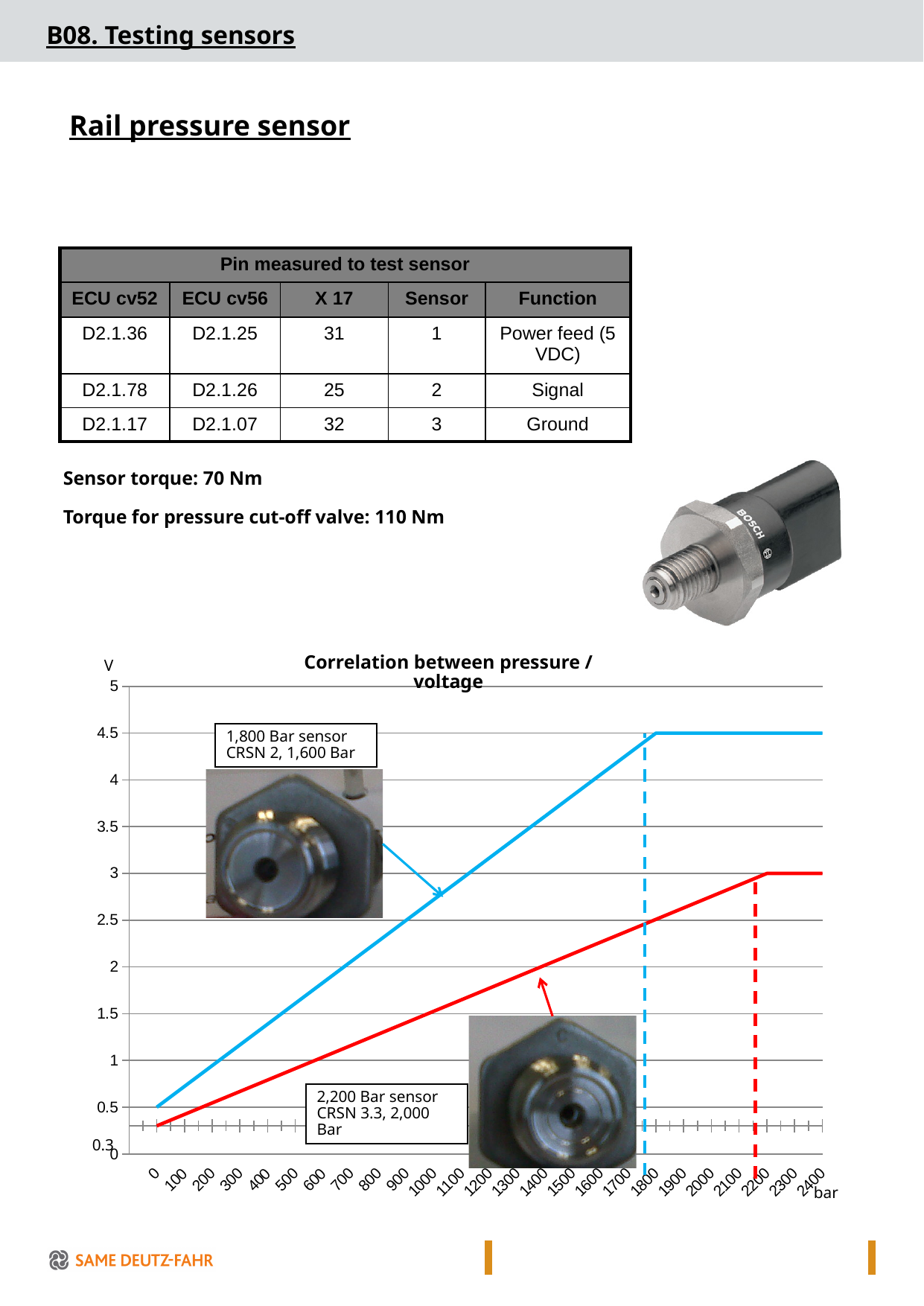
What maximum voltage does the 1,800 Bar sensor (blue line) level off at? 4.5 Is the voltage of the 1,800 Bar sensor (blue line) at 1000 bar greater or less than 2? greater How many sensor curves are plotted on the pressure/voltage chart? 2 Which sensor curve reaches the higher maximum voltage? 1,800 Bar sensor What maximum voltage does the 2,200 Bar sensor (red line) level off at? 3 At what pressure does the blue 1,800 Bar sensor line reach its plateau? 1800 bar What is the title of the chart at the bottom of the slide? Correlation between pressure / voltage Do the sensor voltages rise or fall as pressure increases from 0 to 1800 bar? rise What is the difference between the plateau voltages of the 1,800 Bar sensor and the 2,200 Bar sensor? 1.5 At what pressure does the red 2,200 Bar sensor line reach its plateau? 2200 bar Is the voltage of the 2,200 Bar sensor (red line) at 1000 bar greater or less than 2? less What type of chart is shown under the title "Correlation between pressure / voltage"? line chart